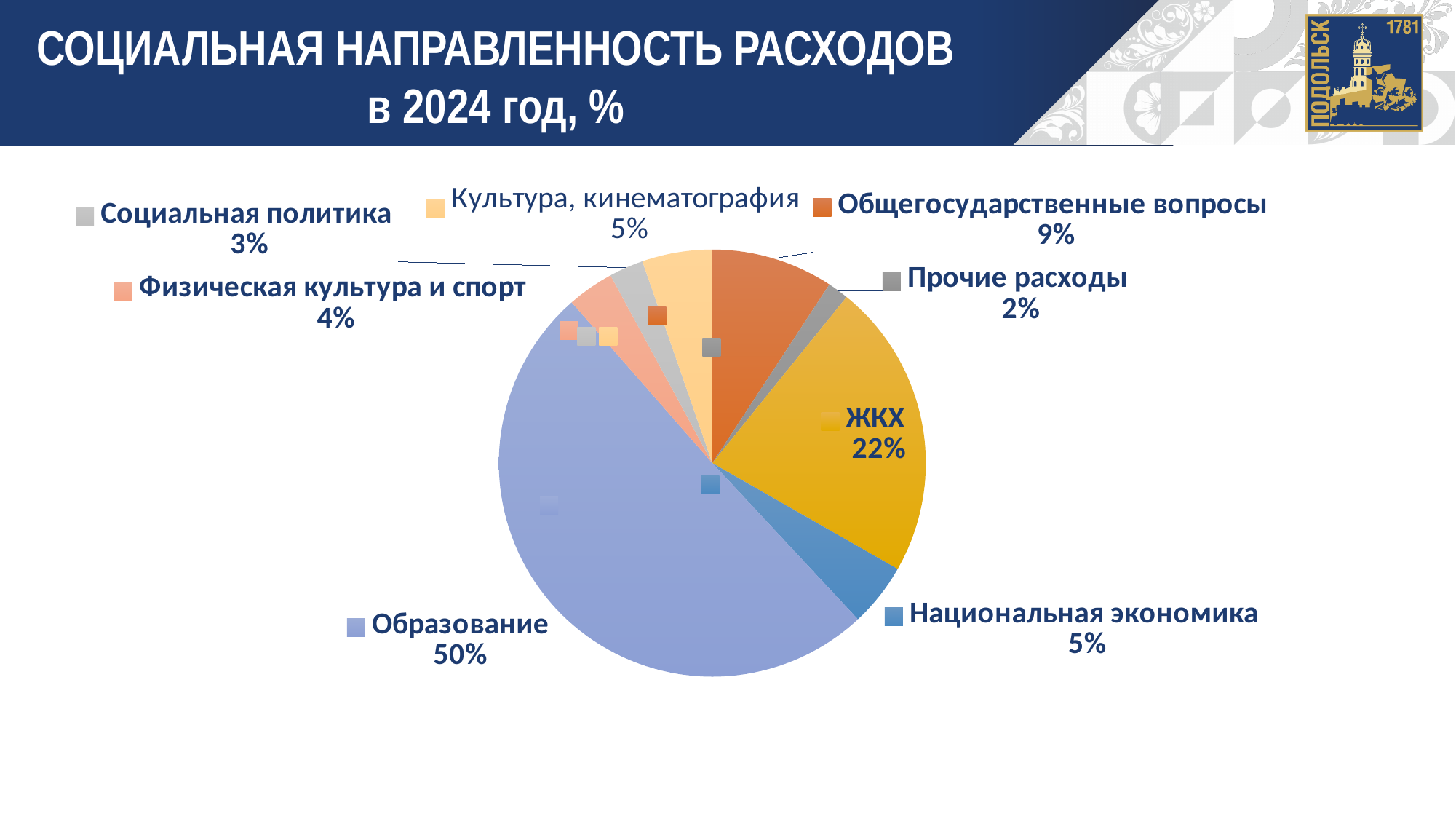
What is the difference between the shares of Образование and ЖКХ? 28 percentage points What type of chart is shown on the slide? Pie chart What share of expenditures does Образование account for? 50% What is the value shown for ЖКХ? 22% How many categories are shown in the pie chart? 8 What percentage is shown for Общегосударственные вопросы? 9% Which category has the smallest share of the pie? Прочие расходы Which is larger, the share for Общегосударственные вопросы or the share for Национальная экономика? Общегосударственные вопросы Which category has the largest share of the pie? Образование What share is shown for Физическая культура и спорт? 4% What is the value for Прочие расходы? 2% What is the title of the chart on the slide? СОЦИАЛЬНАЯ НАПРАВЛЕННОСТЬ РАСХОДОВ в 2024 год, %